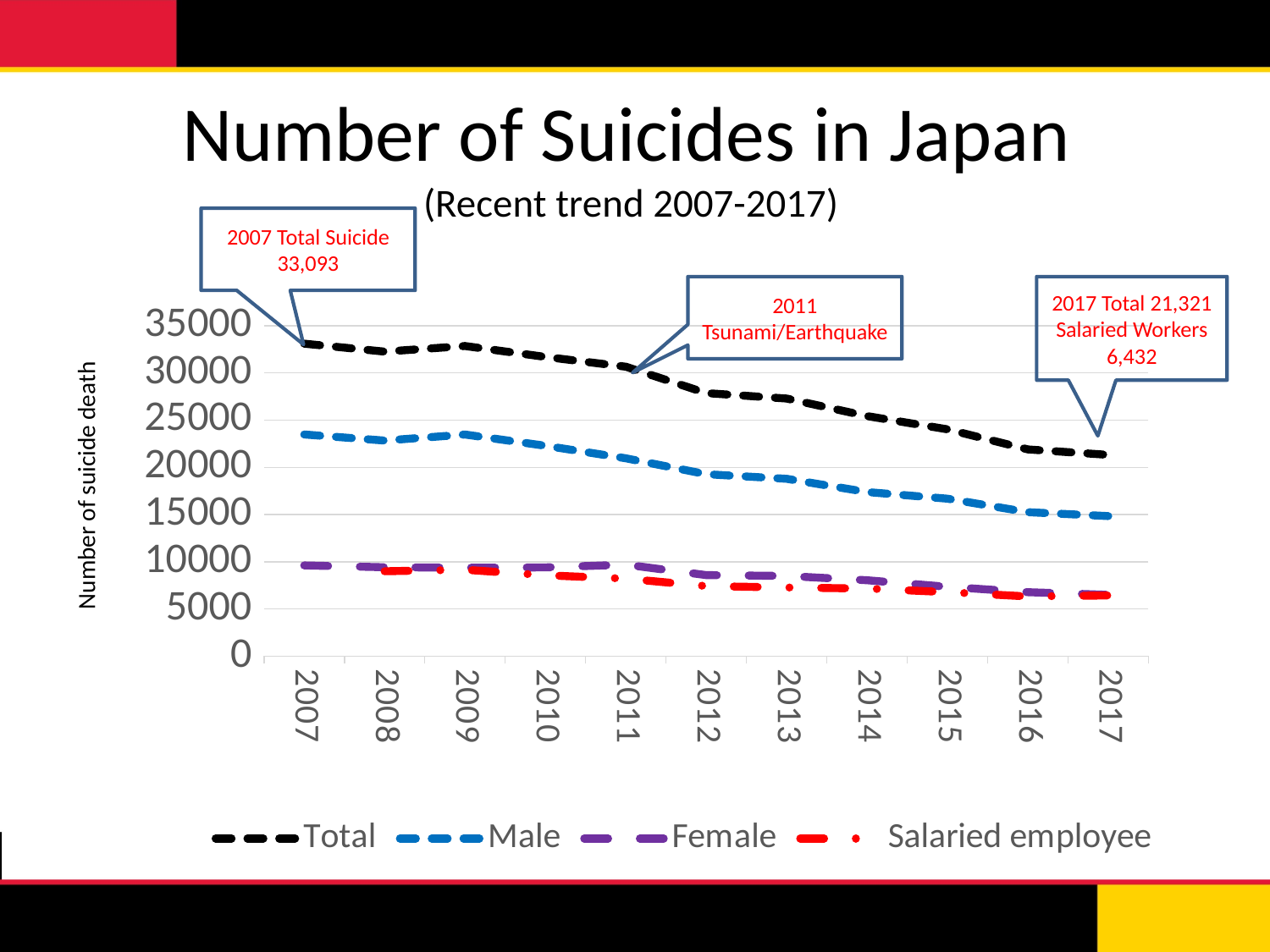
How many series does the legend list? 4 In 2007, which series has the larger value, Male or Female? Male What was the total number of suicides in Japan in 2017, according to the callout on the chart? 21,321 By how much did the total number of suicides fall between 2007 (33,093) and 2017 (21,321)? 11,772 Is the value for Male in 2007 greater or less than 20000? greater How many suicides among salaried workers are reported for 2017 in the callout? 6,432 What was the total number of suicides in Japan in 2007, according to the callout on the chart? 33,093 Is the value for Female in 2017 greater or less than 10000? less What event does the callout at 2011 on the chart refer to? Tsunami/Earthquake Does the Total series rise or fall from 2007 to 2017? Fall What kind of chart is shown on the slide? Line chart How many years are plotted along the x axis? 11